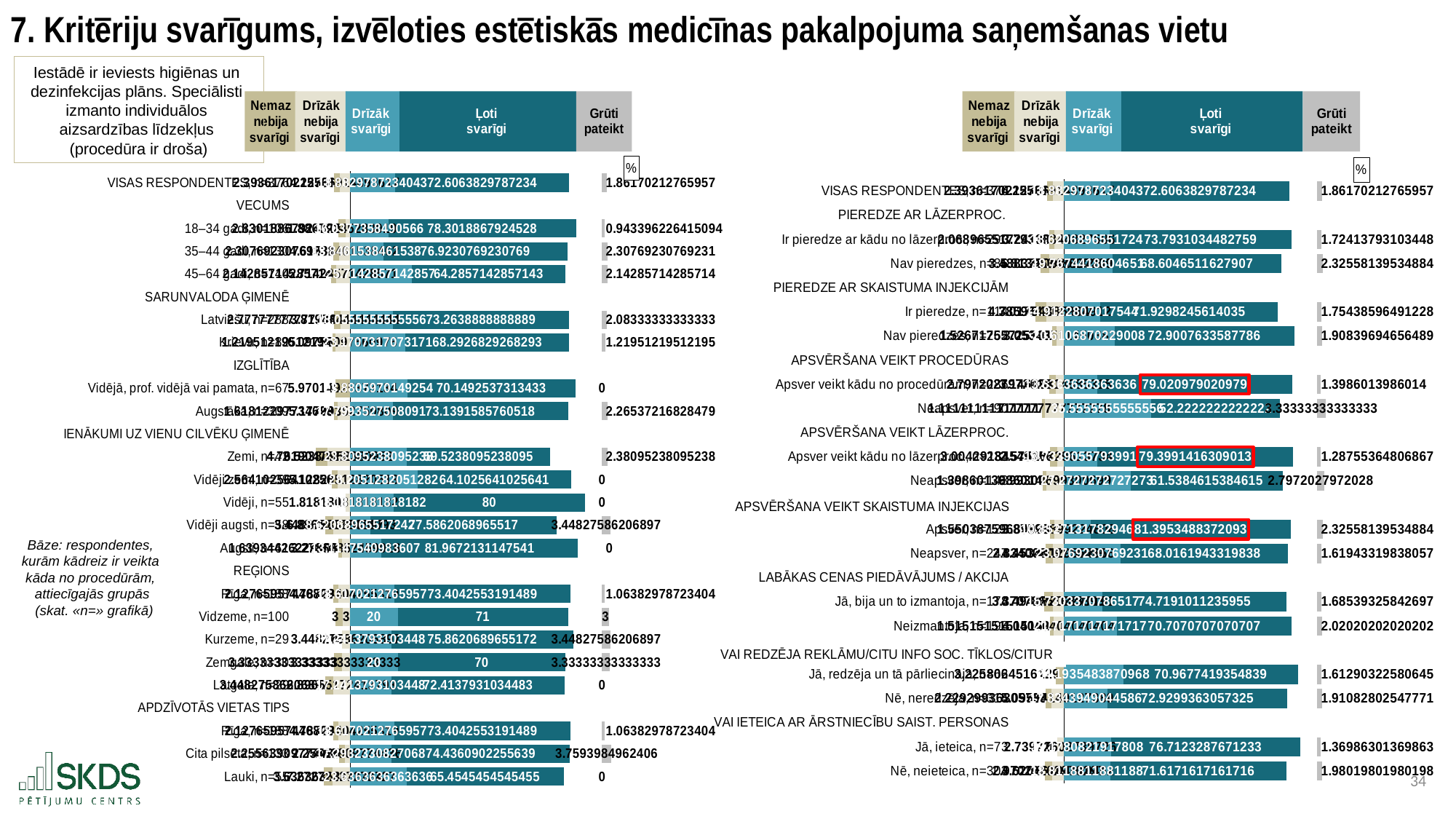
In the left chart, what is the 'Grūti pateikt' value for 'Cita pilsēta'? 3.7593984962406 How many series does the legend above the left chart list? 5 In the left chart, what is the 'Ļoti svarīgi' value for 'Vidzeme, n=100'? 71 In the left chart, what is the difference between the 'Ļoti svarīgi' values for 'Vidēji, n=55' and 'Vidzeme, n=100'? 9 In the right chart, what is the red-boxed 'Ļoti svarīgi' value for the row about considering beauty injections ('Apsver')? 81.3953488372093 In the left chart, what is the 'Drīzāk svarīgi' value for 'Vidzeme, n=100'? 20 In the right chart, what is the 'Ļoti svarīgi' value highlighted with a red box for 'Apsver veikt kādu no lāzerproc.'? 79.3991416309013 In the left chart, which has the larger 'Ļoti svarīgi' value: 'Vidēji, n=55' or 'Vidzeme, n=100'? Vidēji, n=55 In the left chart, what is the 'Ļoti svarīgi' value for 'Vidēji, n=55'? 80 In the left chart, what is the 'Grūti pateikt' value for 'VISAS RESPONDENTES'? 1.86170212765957 In the right chart, what is the 'Grūti pateikt' value for 'Nē, neieteica'? 1.98019801980198 What kind of chart is used on the left side of the slide? bar chart